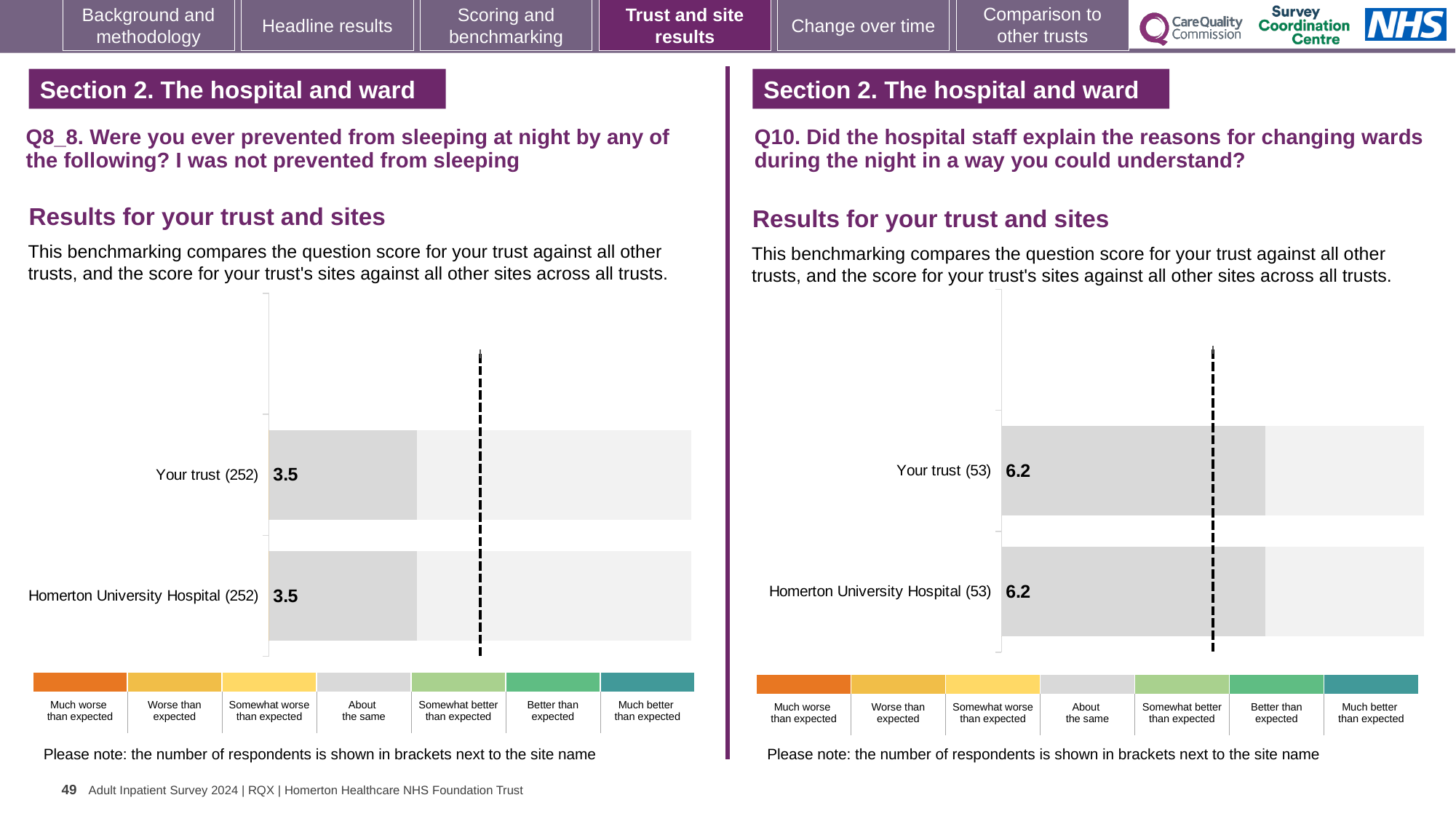
On the right chart (Q10), what is the difference between the score for Your trust and the score for Homerton University Hospital? 0 How many bars are plotted on the right chart (Q10)? 2 On the left chart (Q8_8), what is the score for Your trust? 3.5 On the left chart (Q8_8), what is the difference between the score for Your trust and the score for Homerton University Hospital? 0 On the right chart (Q10), how many respondents are shown in brackets for Homerton University Hospital? 53 On the right chart (Q10), what is the score for Your trust? 6.2 What kind of chart is used on the left (Q8_8)? Bar chart On the left chart (Q8_8), what is the score for Homerton University Hospital? 3.5 On the left chart (Q8_8), how many respondents are shown in brackets for Your trust? 252 How many categories does the colour key below the right chart (Q10) list? 7 On the right chart (Q10), what is the score for Homerton University Hospital? 6.2 How many bars are plotted on the left chart (Q8_8)? 2